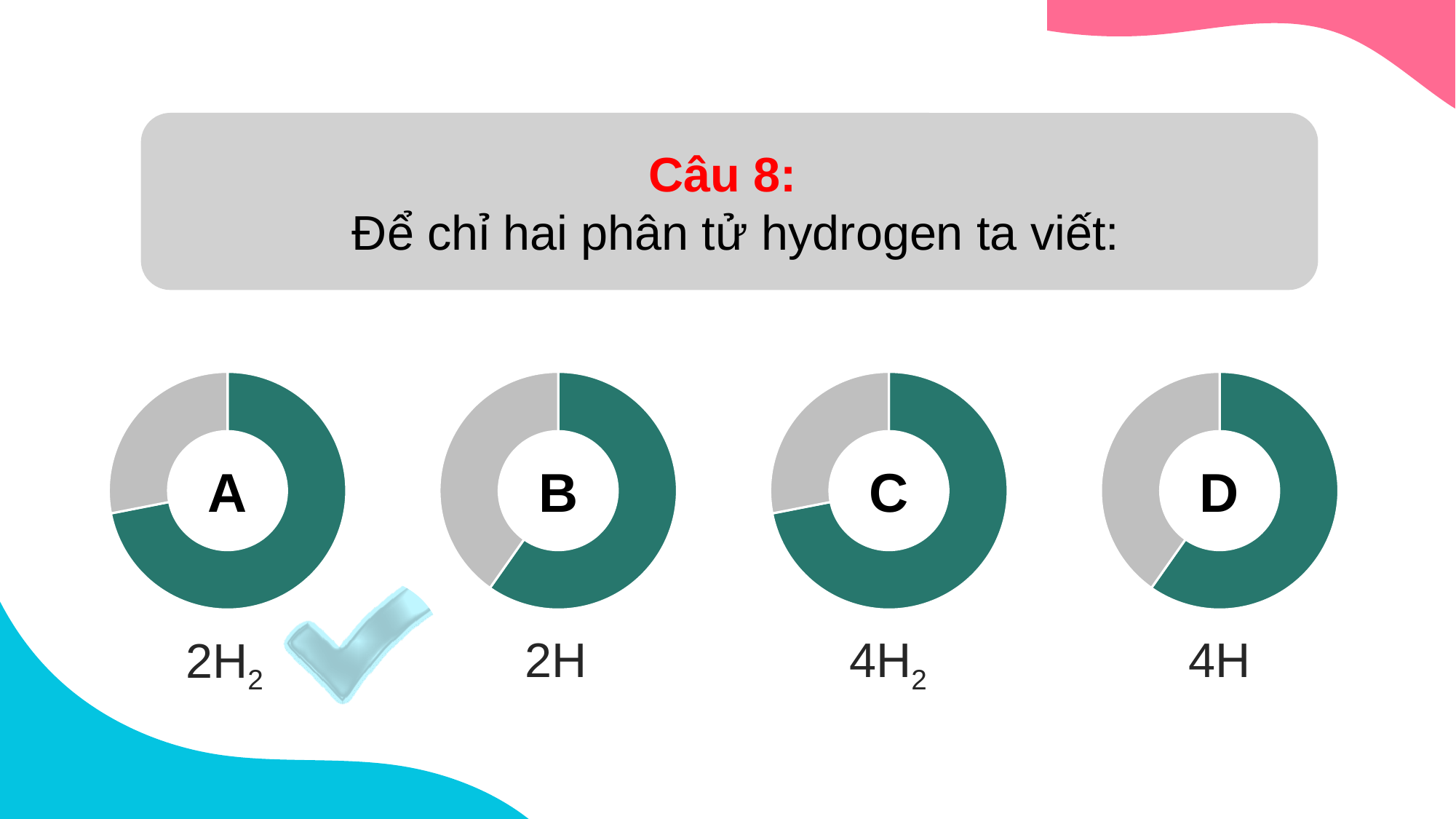
In the chart labelled D, which segment is larger, the green one or the grey one? green What letter is printed in the centre of the leftmost donut chart? A In the chart labelled C, which segment is larger, the green one or the grey one? green How many donut charts are shown on the slide? 4 How many segments does the chart labelled A have? 2 What text appears below the chart labelled C? 4H₂ In the chart labelled A, which segment is larger, the green one or the grey one? green What kind of chart is used for option A on the slide? pie chart (donut)